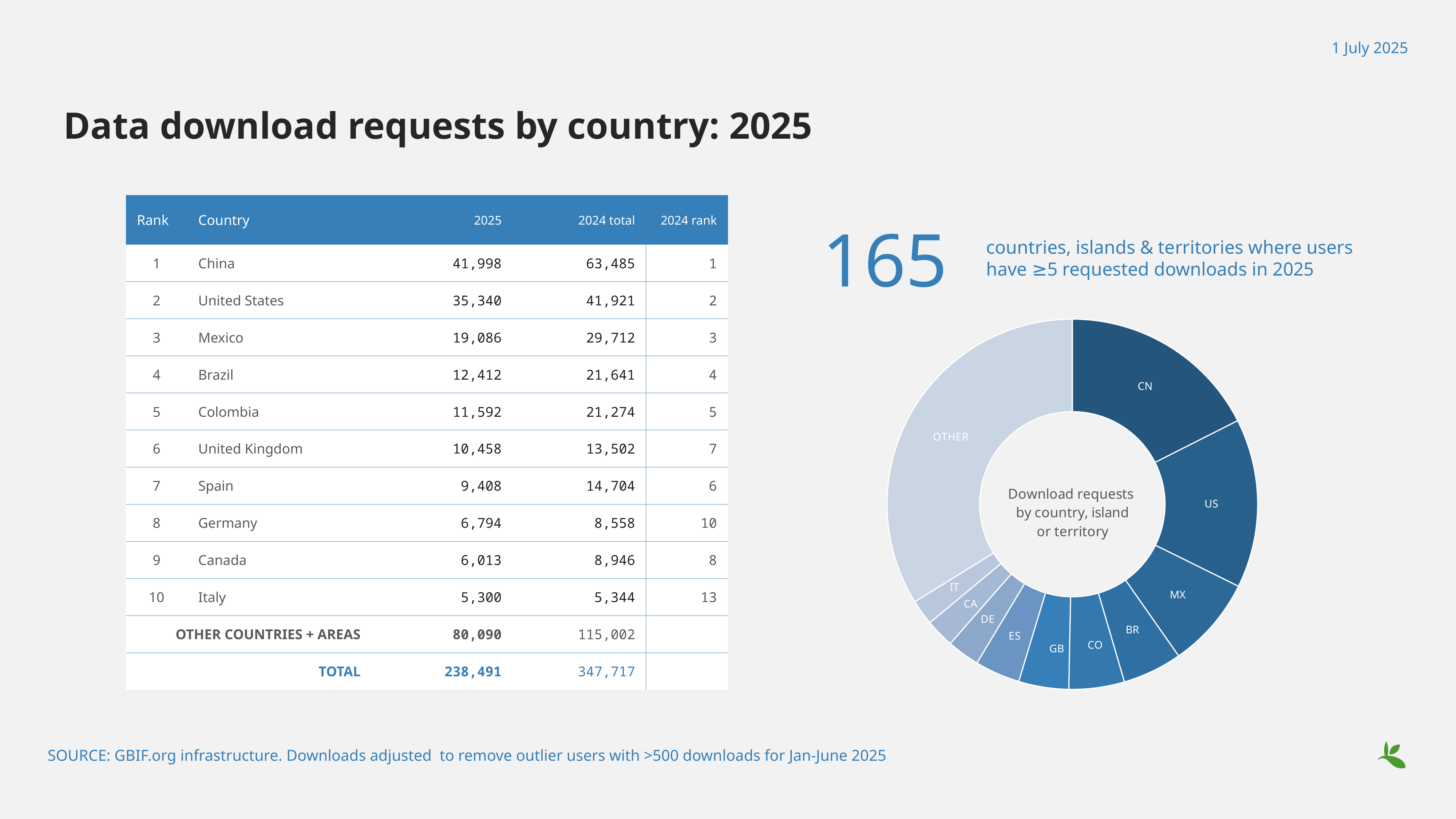
How many slices does the donut chart have? 11 What text is written in the centre of the donut chart? Download requests by country, island or territory Which labelled slice of the donut chart is the smallest? IT Excluding the OTHER slice, which country has the largest slice in the donut chart? CN In the donut chart, is the CN slice larger or smaller than the OTHER slice? smaller According to the slide, what is the total number of download requests in 2025? 238,491 What kind of chart is shown on the right of the slide? donut chart Which slice of the donut chart is shown in the darkest blue? CN In the donut chart, is the ES slice larger or smaller than the DE slice? larger Which slice of the donut chart is the largest? OTHER In the donut chart, is the US slice larger or smaller than the MX slice? larger According to the slide, how many download requests did China (CN) make in 2025? 41,998